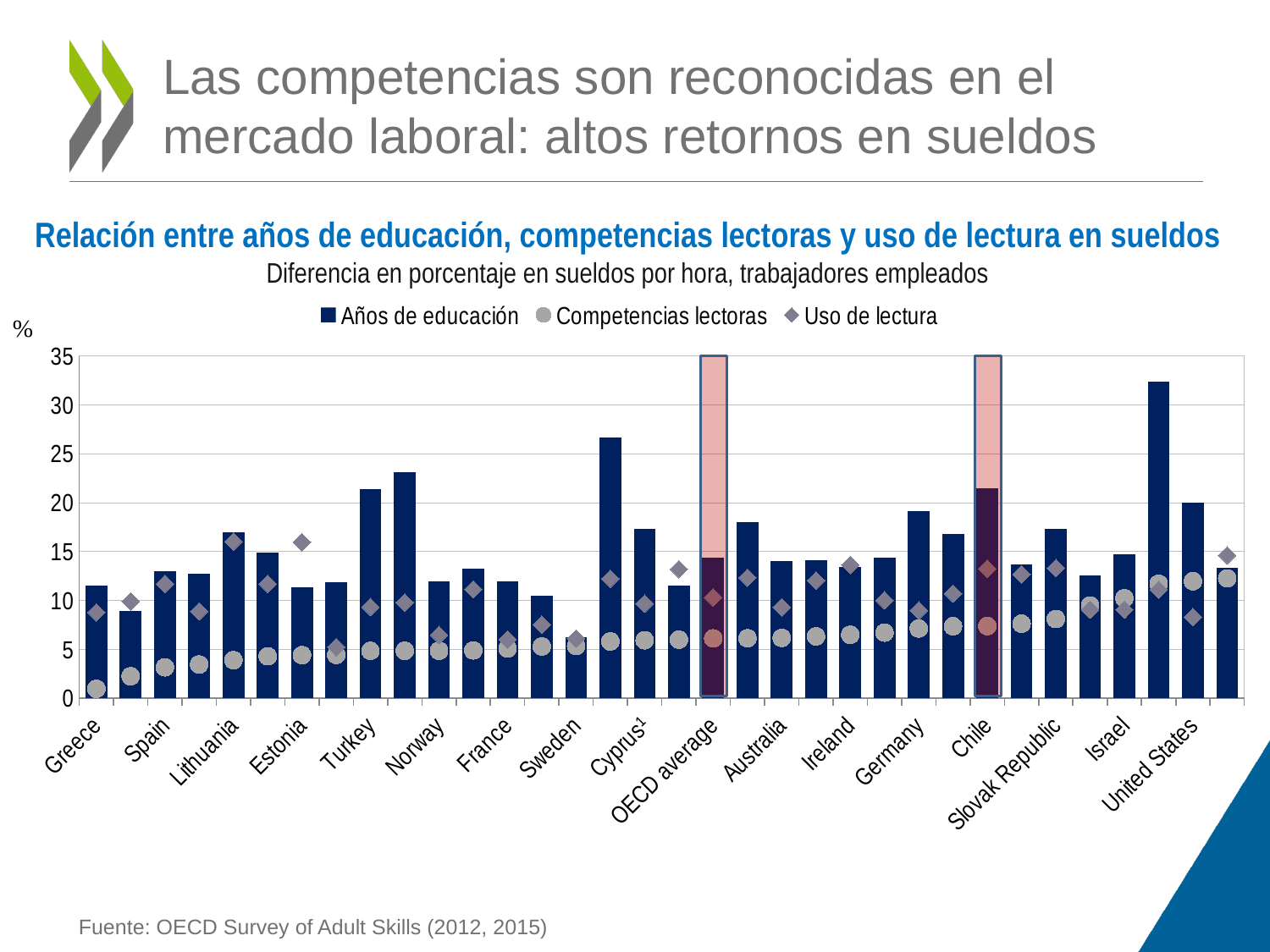
Is the Competencias lectoras value for Greece greater or less than 5? less What is the highest value shown on the vertical axis? 35 Is the Años de educación value for Chile greater or less than 15? greater For Greece, which is larger, the Uso de lectura value or the Competencias lectoras value? Uso de lectura Is the Años de educación value for OECD average greater or less than 10? greater Which has the larger Años de educación value, Sweden or Germany? Germany How many series does the legend list? 3 Which has the larger Años de educación value, Chile or OECD average? Chile What kind of chart is shown on the slide? bar chart What are the three series named in the legend? Años de educación, Competencias lectoras, Uso de lectura